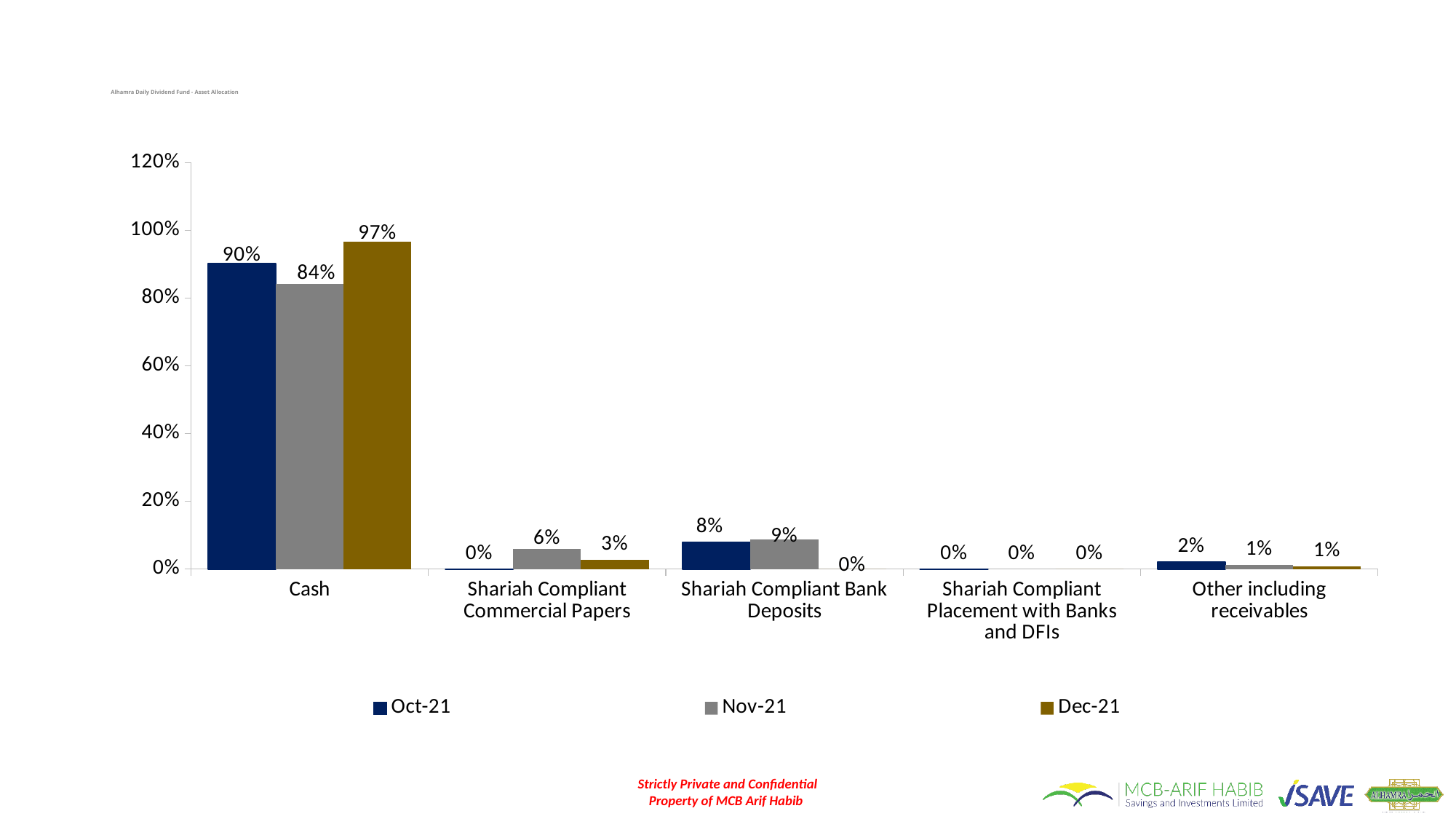
What is the Dec-21 value for Shariah Compliant Commercial Papers? 3% What kind of chart is shown on the slide? Bar chart Is the Oct-21 value for Cash greater or less than 80%? greater What is the Dec-21 value for Cash? 97% What is the Oct-21 value for Other including receivables? 2% How many categories are shown on the x axis? 5 Which month has the lowest value for Cash? Nov-21 Which month has the highest value for Cash? Dec-21 Which is larger for Shariah Compliant Commercial Papers, the Nov-21 value or the Dec-21 value? Nov-21 What is the difference between the Dec-21 and Nov-21 values for Cash? 13% What is the Nov-21 value for Shariah Compliant Bank Deposits? 9% How many series does the legend list? 3